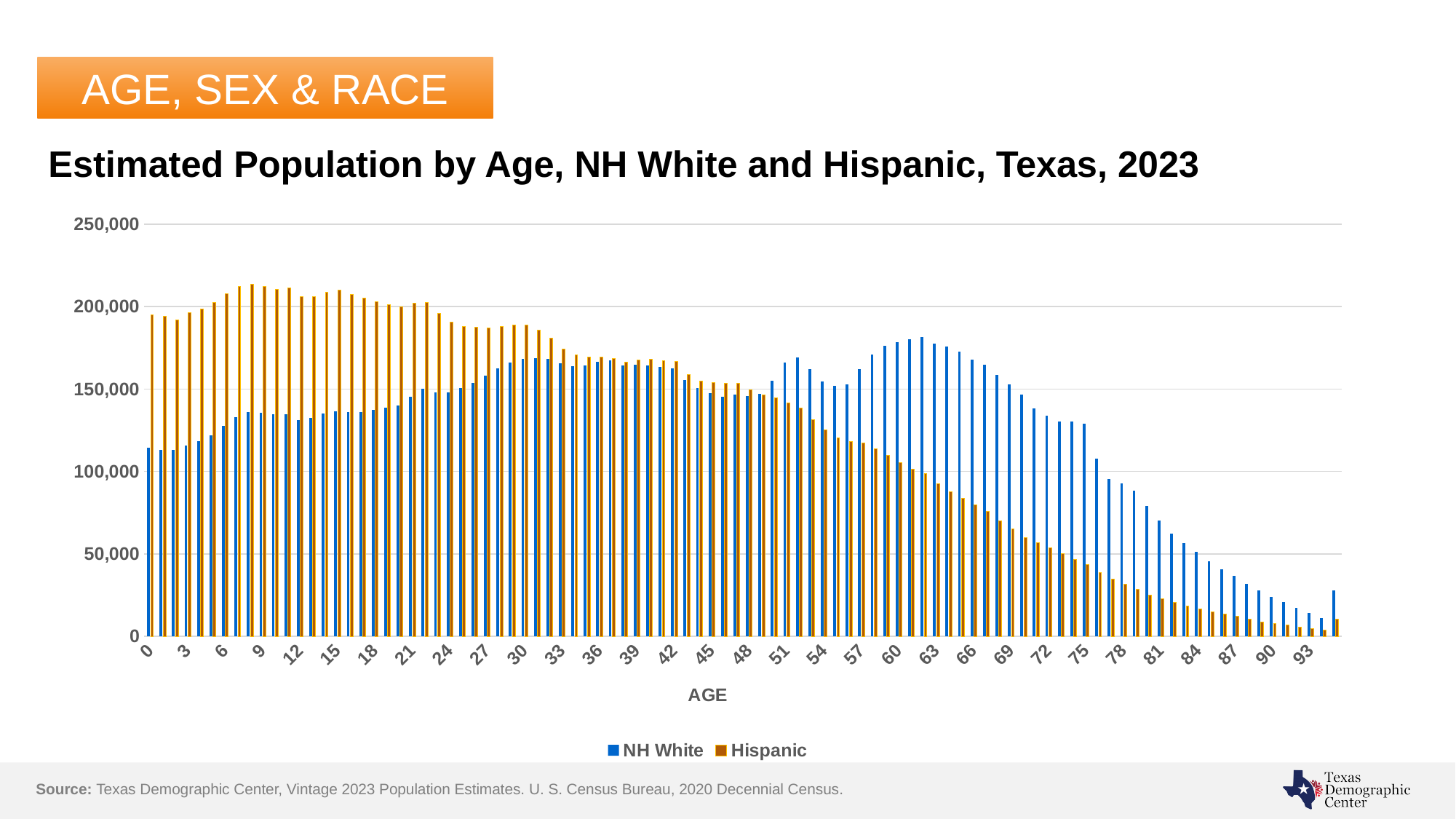
Is the Hispanic value at age 0 greater or less than 150,000? greater Which two series are shown in the legend? NH White and Hispanic At age 75, which series has the larger value, NH White or Hispanic? NH White Is the Hispanic value at age 9 greater or less than 200,000? greater At age 0, which series has the larger value, NH White or Hispanic? Hispanic Is the NH White value at age 0 greater or less than 150,000? less How many series does the legend list? 2 Do the Hispanic values rise or fall from age 60 to age 93? fall What kind of chart is shown on the slide? bar chart What is the label of the x axis? AGE